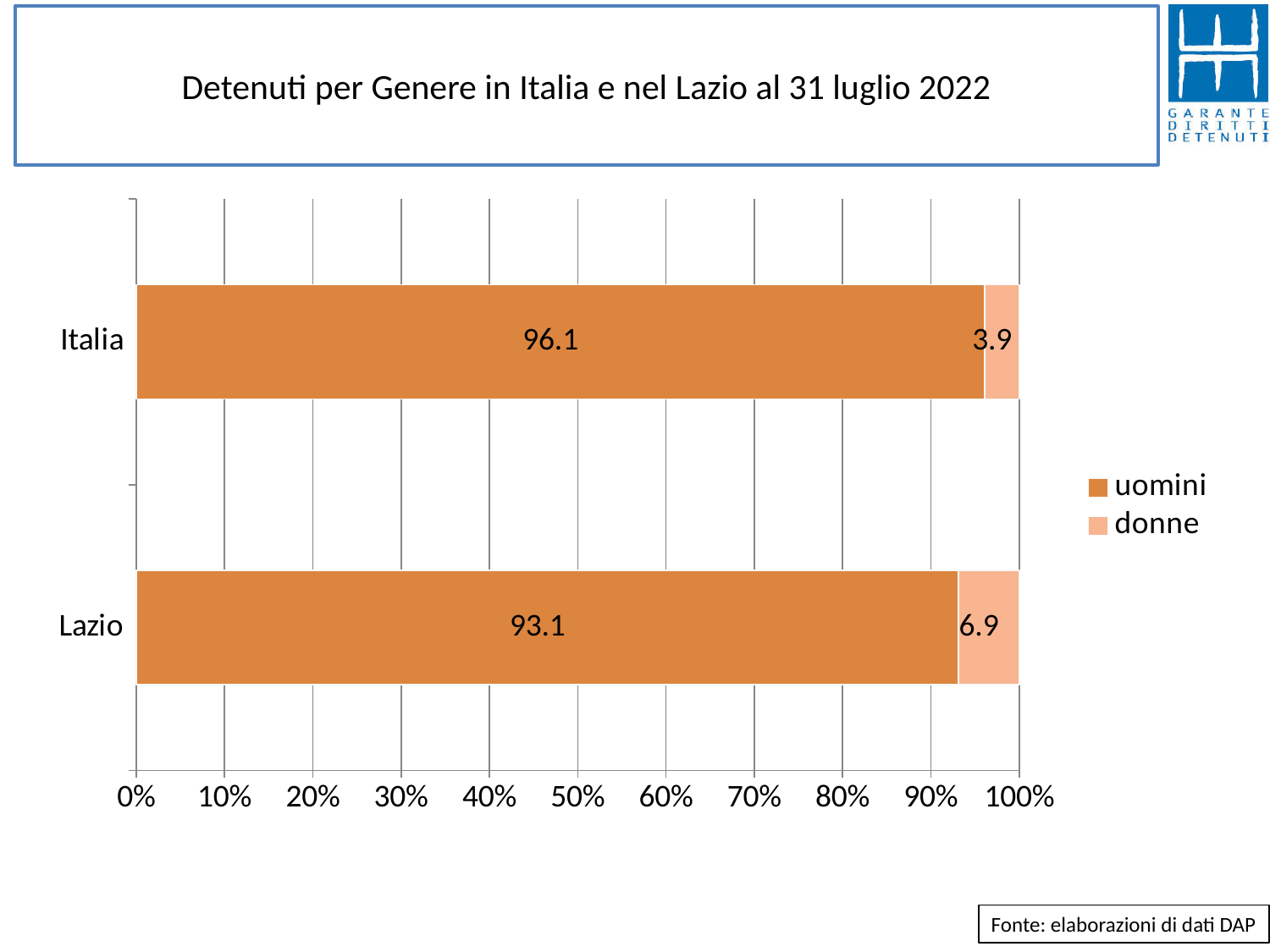
What is the title of the chart? Detenuti per Genere in Italia e nel Lazio al 31 luglio 2022 What is the value for donne in Lazio? 6.9 How many series does the legend list? 2 What is the value for uomini in Lazio? 93.1 What is the total of the stacked bar for Lazio? 100 Which category has the higher value for donne, Italia or Lazio? Lazio Which category has the lowest value for uomini? Lazio What is the value for donne in Italia? 3.9 What is the difference between the uomini values for Italia and Lazio? 3 How many categories are shown on the chart? 2 What kind of chart is shown on the slide? Stacked bar chart What is the value for uomini in Italia? 96.1